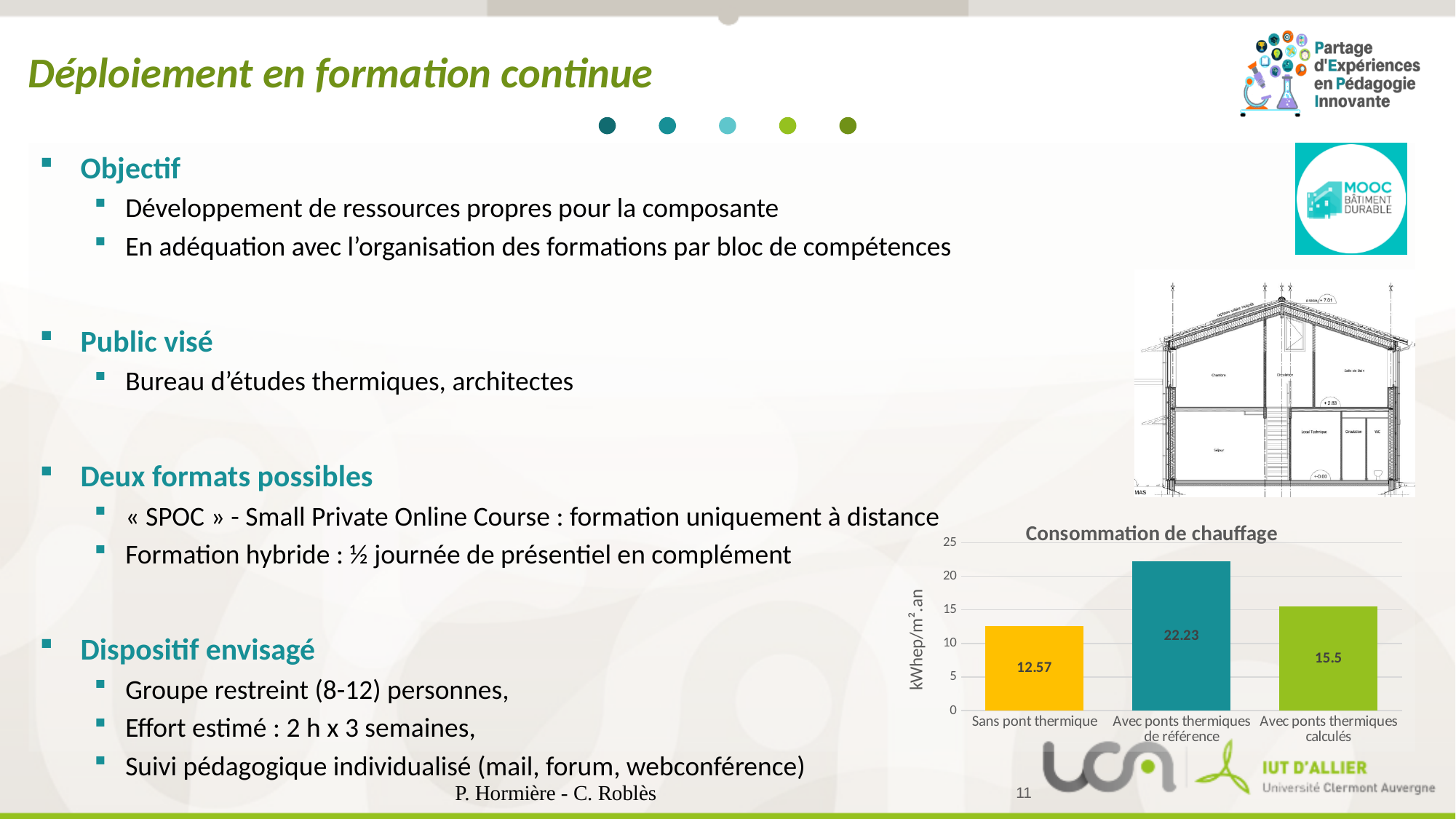
What is the y-axis label of the 'Consommation de chauffage' chart? kWhep/m².an What is the difference between the values for 'Avec ponts thermiques calculés' and 'Sans pont thermique' in the 'Consommation de chauffage' chart? 2.93 What is the value for 'Sans pont thermique' in the 'Consommation de chauffage' chart? 12.57 What is the value for 'Avec ponts thermiques calculés' in the 'Consommation de chauffage' chart? 15.5 What is the value for 'Avec ponts thermiques de référence' in the 'Consommation de chauffage' chart? 22.23 How many categories are shown in the 'Consommation de chauffage' chart? 3 What kind of chart is 'Consommation de chauffage'? Bar chart Is the value for 'Avec ponts thermiques de référence' in the 'Consommation de chauffage' chart greater or less than 20? greater Which category has the lowest value in the 'Consommation de chauffage' chart? Sans pont thermique What is the difference between the values for 'Avec ponts thermiques de référence' and 'Sans pont thermique' in the 'Consommation de chauffage' chart? 9.66 Which category has the highest value in the 'Consommation de chauffage' chart? Avec ponts thermiques de référence In the 'Consommation de chauffage' chart, which is larger: 'Avec ponts thermiques calculés' or 'Avec ponts thermiques de référence'? Avec ponts thermiques de référence